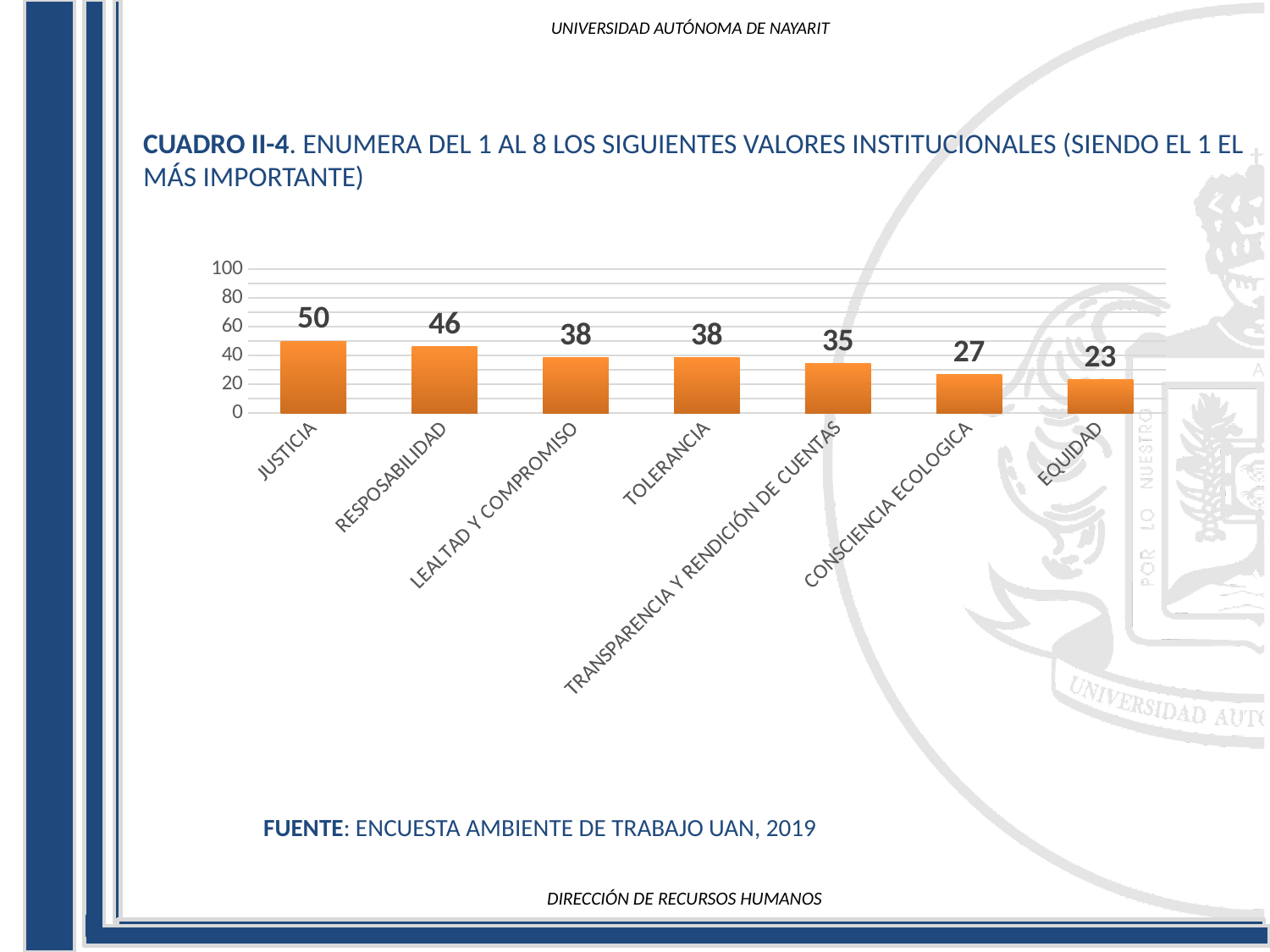
What is the value for TRANSPARENCIA Y RENDICIÓN DE CUENTAS? 35 What is the difference between the values for JUSTICIA and EQUIDAD? 27 Which category has the lowest value? EQUIDAD What is the value for JUSTICIA? 50 What is the value for CONSCIENCIA ECOLOGICA? 27 How many categories are shown in the chart? 7 Which is larger, the value for RESPOSABILIDAD or the value for CONSCIENCIA ECOLOGICA? RESPOSABILIDAD Which category has the highest value? JUSTICIA Do the values rise or fall from left to right along the x axis? fall Is the value for LEALTAD Y COMPROMISO greater or less than 20? greater What kind of chart is shown on the slide? bar chart What is the difference between the values for RESPOSABILIDAD and TOLERANCIA? 8